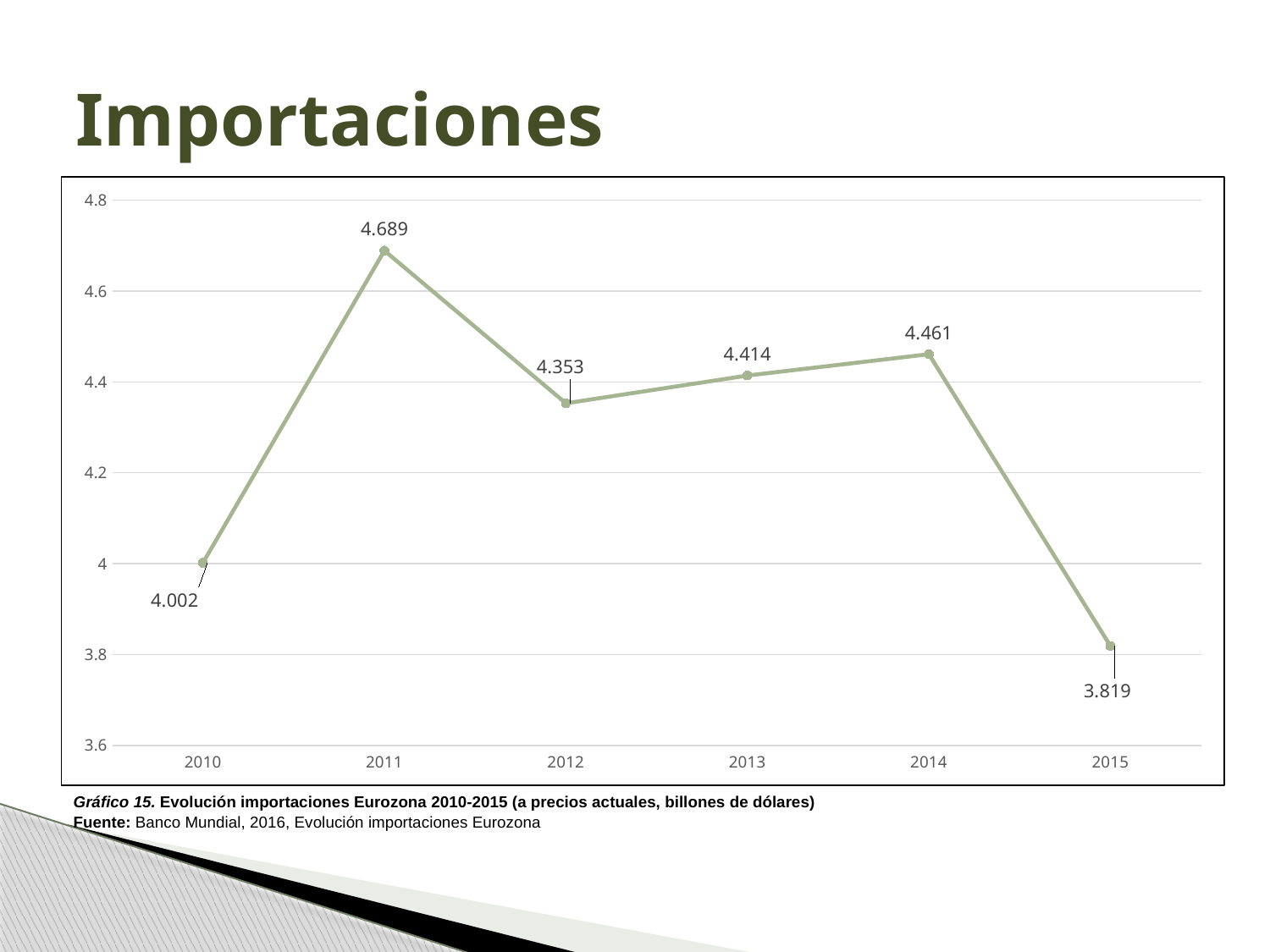
What is the value for 2011? 4.689 What kind of chart is shown on the slide? line chart What is the difference between the values for 2011 and 2010? 0.687 What is the difference between the values for 2014 and 2015? 0.642 Is the value for 2010 greater or less than 4.2? less What is the value for 2015? 3.819 Do the values rise or fall from 2014 to 2015? fall Which is larger, the value for 2012 or the value for 2014? 2014 What is the value for 2013? 4.414 How many years are plotted on the chart? 6 Which year has the highest value? 2011 Which year has the lowest value? 2015